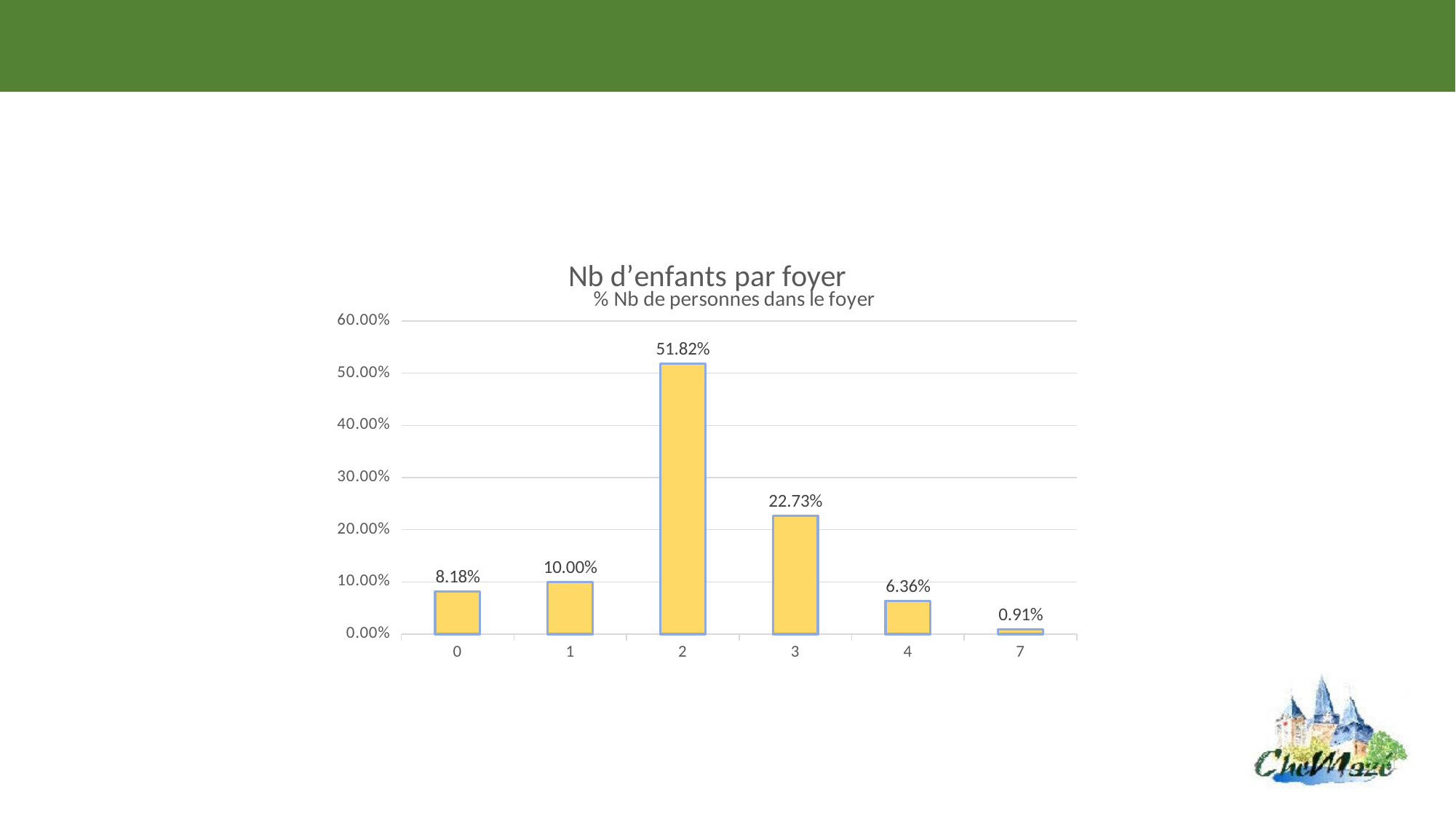
How many categories are shown on the x axis? 6 What is the value for category 0? 8.18% Which category has the lowest value? 7 Which category has the highest value? 2 What is the value for category 2? 51.82% What kind of chart is this? bar chart What is the difference between the values for categories 1 and 0? 1.82% What is the value for category 7? 0.91% What is the difference between the values for categories 2 and 3? 29.09% What is the title of the chart? Nb d’enfants par foyer Which is larger, the value for category 1 or the value for category 4? 1 Is the value for category 3 greater or less than 20.00%? greater